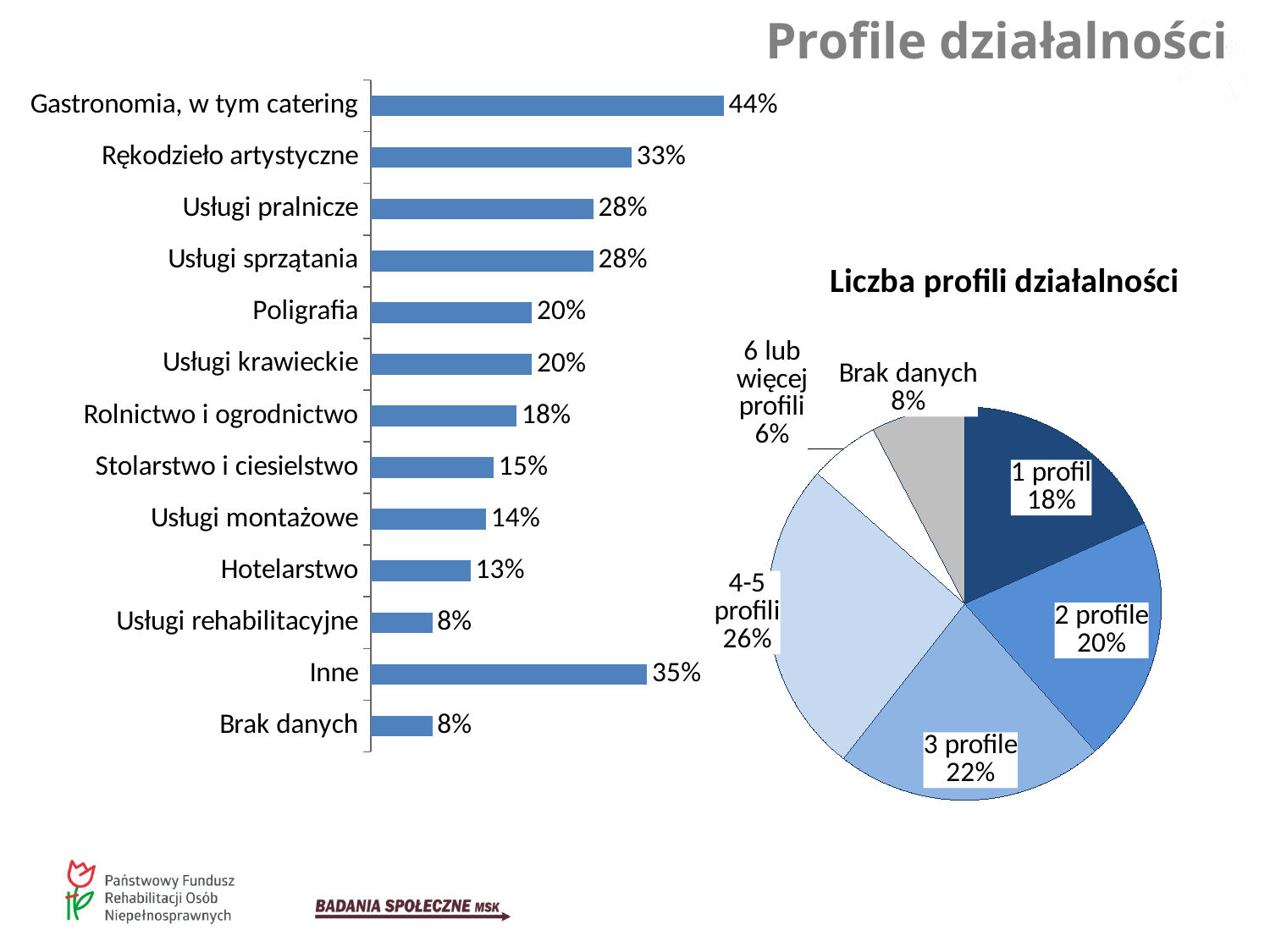
How many categories does the bar chart on the left show? 13 In the bar chart on the left, which category has the highest value? Gastronomia, w tym catering In the bar chart on the left, what is the value for Hotelarstwo? 13% In the bar chart on the left, what is the value for Gastronomia, w tym catering? 44% How many slices does the pie chart 'Liczba profili działalności' have? 6 What is the title of the pie chart on the right? Liczba profili działalności In the pie chart 'Liczba profili działalności', which slice is the largest? 4-5 profili What kind of chart is the chart on the left? bar chart In the bar chart on the left, what is the difference between Rękodzieło artystyczne and Usługi pralnicze? 5% In the pie chart 'Liczba profili działalności', which slice is the smallest? 6 lub więcej profili In the pie chart 'Liczba profili działalności', what share does '3 profile' have? 22% In the bar chart on the left, which is larger: Inne or Rękodzieło artystyczne? Inne